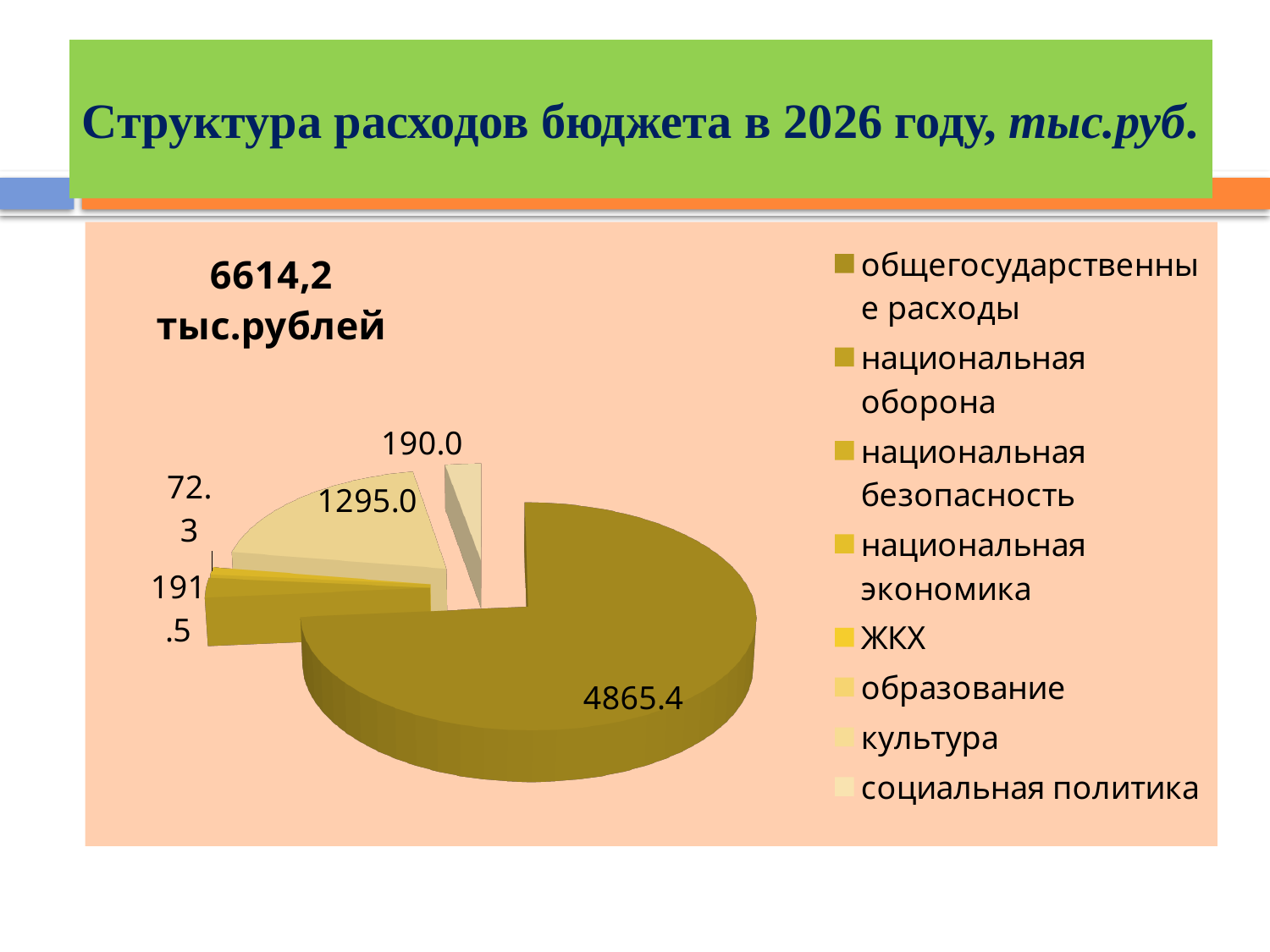
What kind of chart is shown on the slide? pie chart What is the smallest labelled value on the pie? 72.3 What is the total budget expenditure shown on the slide? 6614,2 тыс.рублей How many entries does the legend list? 8 Which is larger, the slice labelled 1295.0 or the slice labelled 190.0? 1295.0 What is the title of the chart? 6614,2 тыс.рублей What is the value for общегосударственные расходы? 4865.4 How many slices of the pie have data labels printed? 5 What is the difference between the slice labelled 191.5 and the slice labelled 72.3? 119.2 What is the difference between the slice labelled 1295.0 and the slice labelled 190.0? 1105.0 What is the value of the largest slice of the pie? 4865.4